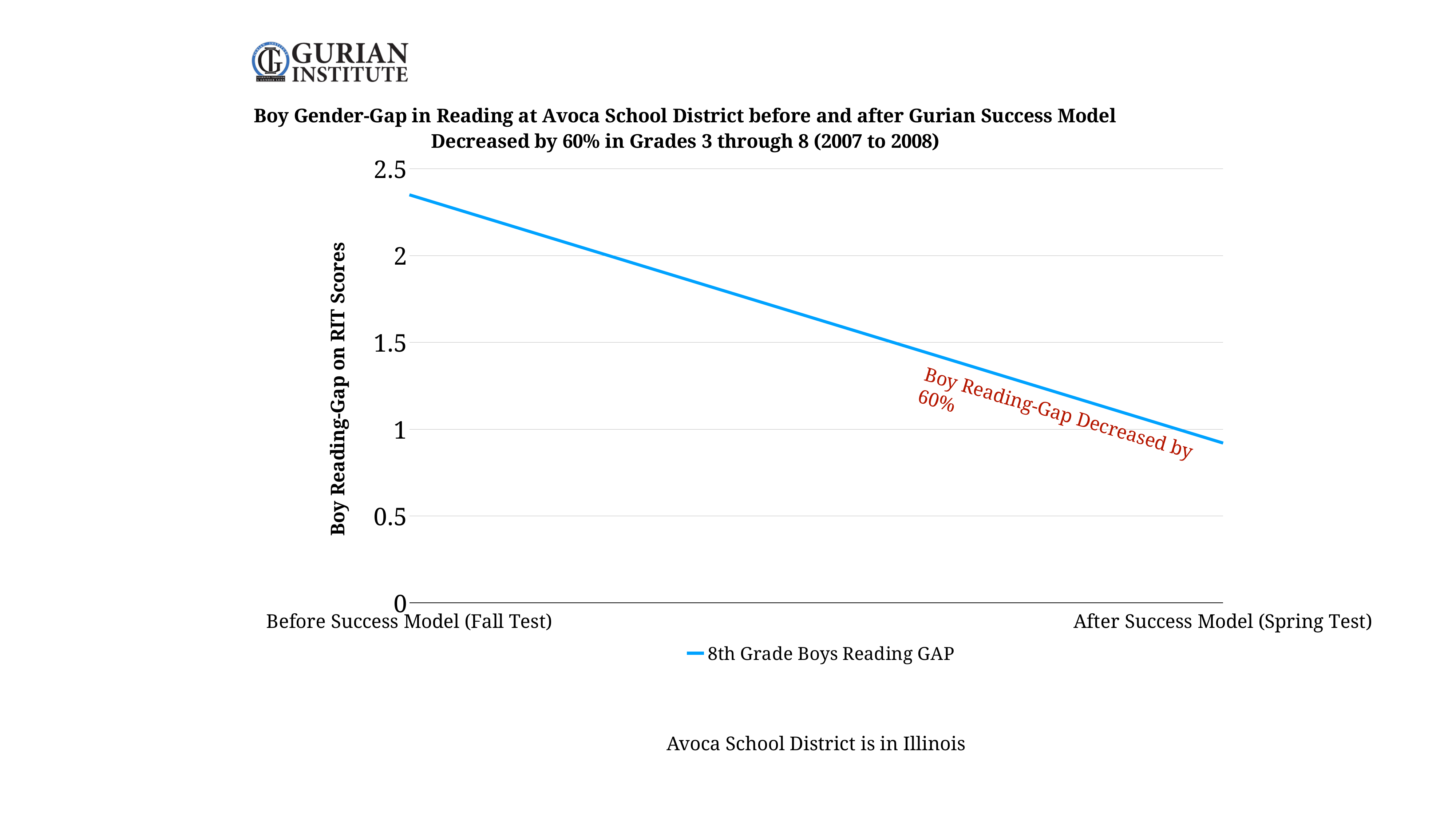
What kind of chart is shown on the slide? line chart Is the value for Before Success Model (Fall Test) greater or less than 2? greater Is the value for After Success Model (Spring Test) greater or less than 1? less What is the label on the vertical axis? Boy Reading-Gap on RIT Scores What is the name of the series shown in the legend? 8th Grade Boys Reading GAP Which category has the higher boy reading gap? Before Success Model (Fall Test) Which category has the lower boy reading gap? After Success Model (Spring Test) Does the boy reading gap rise or fall from the Before Success Model (Fall Test) point to the After Success Model (Spring Test) point? fall Is the value for Before Success Model (Fall Test) greater or less than 2.5? less How many series does the legend list? 1 How many points are plotted on the line? 2 Is the value for Before Success Model (Fall Test) larger or smaller than the value for After Success Model (Spring Test)? larger